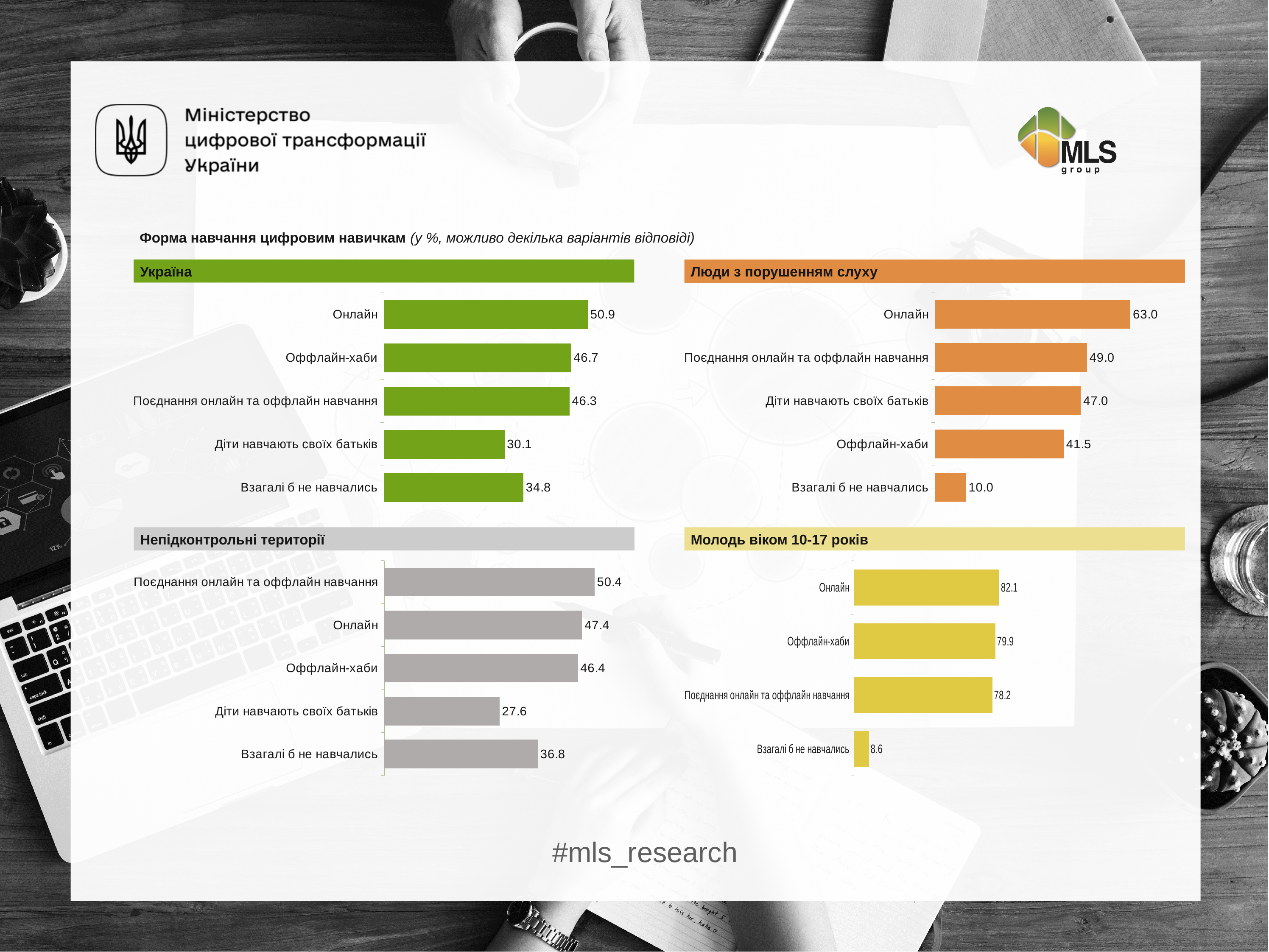
In the "Україна" chart, what is the value for "Онлайн"? 50.9 In the "Молодь віком 10-17 років" chart, what is the value for "Оффлайн-хаби"? 79.9 In the "Непідконтрольні території" chart, which category has the highest value? Поєднання онлайн та оффлайн навчання In the "Люди з порушенням слуху" chart, what is the value for "Взагалі б не навчались"? 10.0 In the "Молодь віком 10-17 років" chart, what is the difference between "Онлайн" and "Взагалі б не навчались"? 73.5 In the "Люди з порушенням слуху" chart, which category has the highest value? Онлайн How many categories does the "Молодь віком 10-17 років" chart show? 4 In the "Україна" chart, which is larger: "Взагалі б не навчались" or "Діти навчають своїх батьків"? Взагалі б не навчались In the "Україна" chart, which category has the lowest value? Діти навчають своїх батьків How many categories does the "Люди з порушенням слуху" chart show? 5 What type of chart is the "Непідконтрольні території" chart? Bar chart In the "Непідконтрольні території" chart, what is the value for "Діти навчають своїх батьків"? 27.6